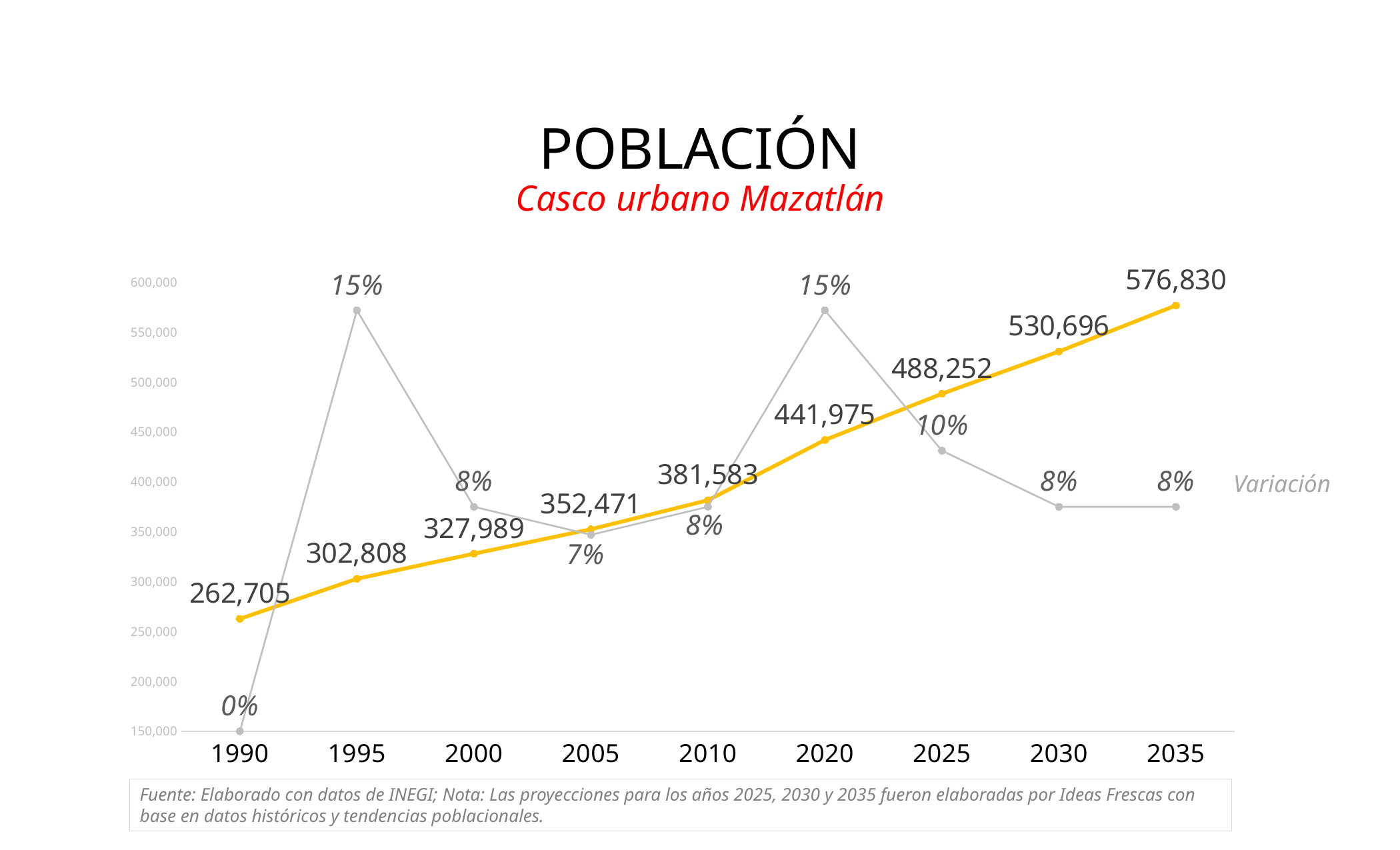
What variation percentage is shown for 2025? 10% What variation percentage is shown for 1995? 15% Which year has the lowest population value on the chart? 1990 How many years are shown on the x axis? 9 Which year has the highest population value on the chart? 2035 What is the difference between the population values for 2035 and 1990? 314,125 Does the population line rise or fall from 1990 to 2035? Rises What is the population value shown for 2035? 576,830 What is the population value shown for 2020? 441,975 Which is larger, the population value for 2010 or for 2020? 2020 What kind of chart is shown on the slide? Line chart What is the population value shown for 1990? 262,705